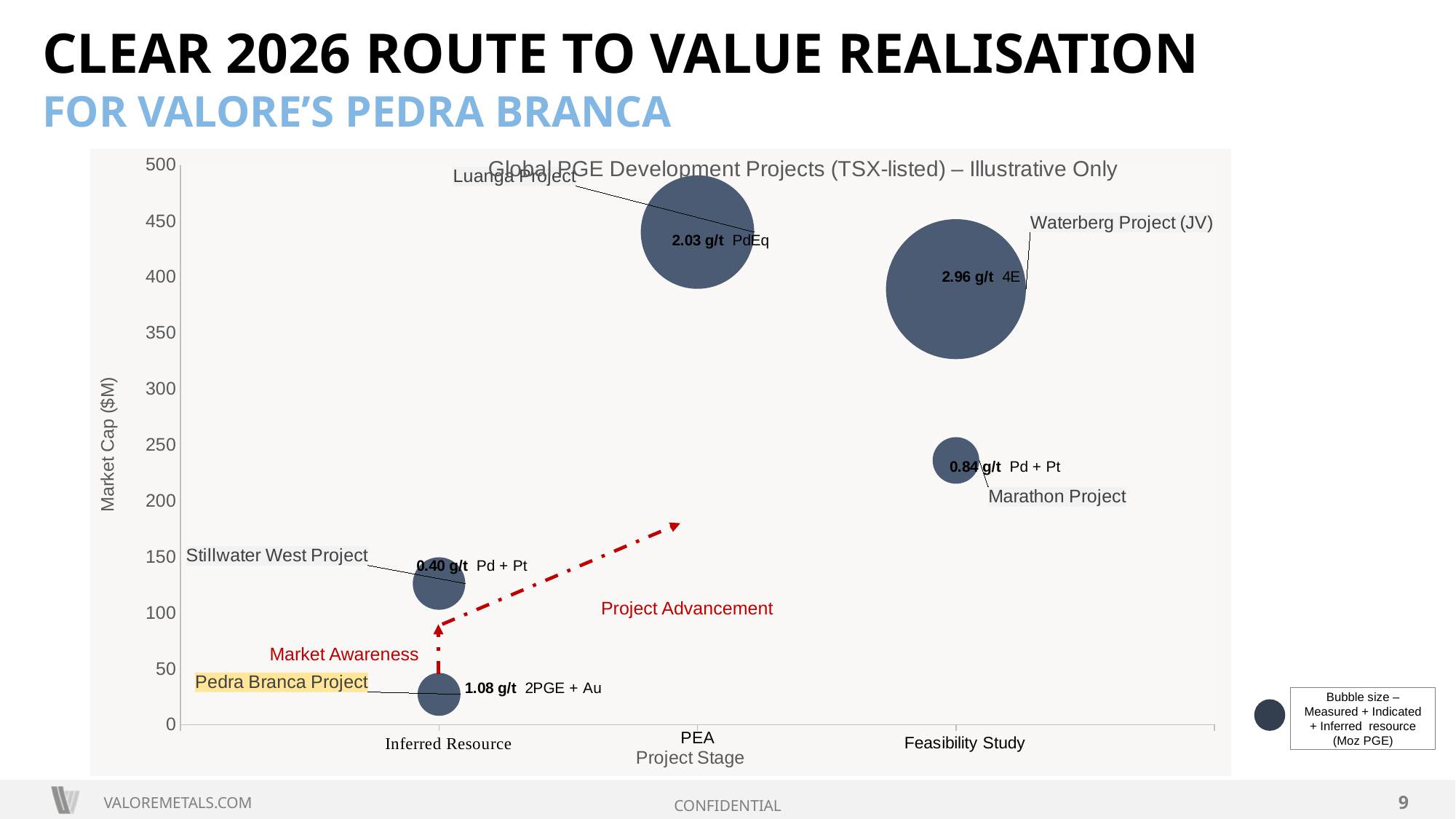
Is the market cap for the Stillwater West Project greater or less than 150? less What kind of chart is shown on the slide? Bubble chart Which project has the highest market cap on the chart? Luanga Project What is the title of the chart? Global PGE Development Projects (TSX-listed) – Illustrative Only Is the market cap for the Waterberg Project (JV) greater or less than 350? greater What grade is labelled on the Luanga Project bubble? 2.03 g/t PdEq What grade is labelled on the Pedra Branca Project bubble? 1.08 g/t 2PGE + Au Which project has the lowest market cap on the chart? Pedra Branca Project How many project bubbles are plotted on the chart? 5 What grade is labelled on the Waterberg Project (JV) bubble? 2.96 g/t 4E Which has the higher market cap, the Marathon Project or the Stillwater West Project? Marathon Project What grade is labelled on the Marathon Project bubble? 0.84 g/t Pd + Pt